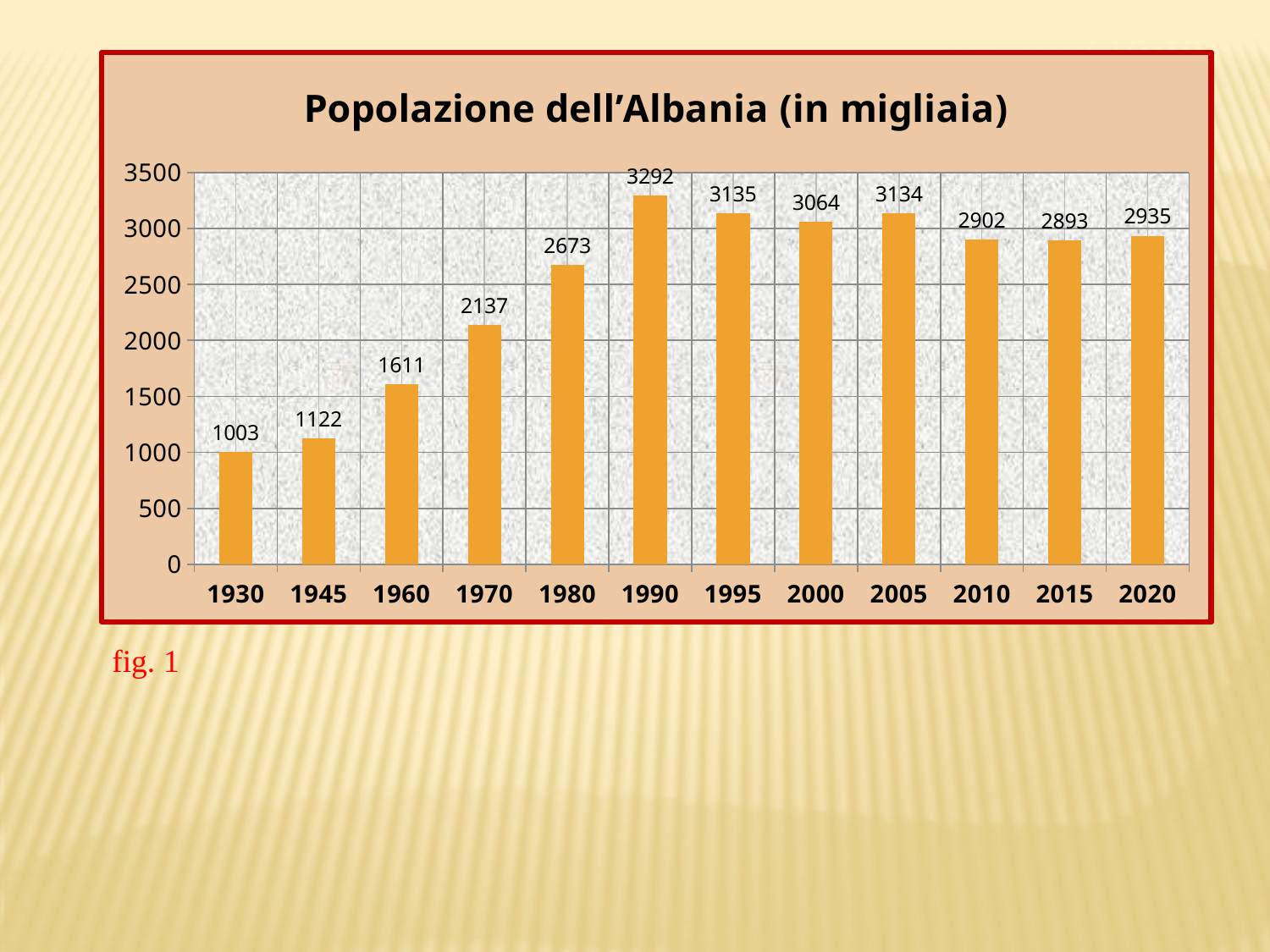
What is the population value shown for 1990? 3292 How many years are shown on the x axis? 12 Which is larger, the value for 1980 or the value for 1970? 1980 What is the population value shown for 1930? 1003 What kind of chart is shown on the slide? bar chart Is the value for 2010 greater or less than 3000? less What is the difference between the values for 2020 and 2015? 42 Which year has the highest population value? 1990 What is the difference between the values for 1990 and 1930? 2289 What is the population value shown for 2020? 2935 Which year has the lowest population value? 1930 What is the title of the chart? Popolazione dell'Albania (in migliaia)